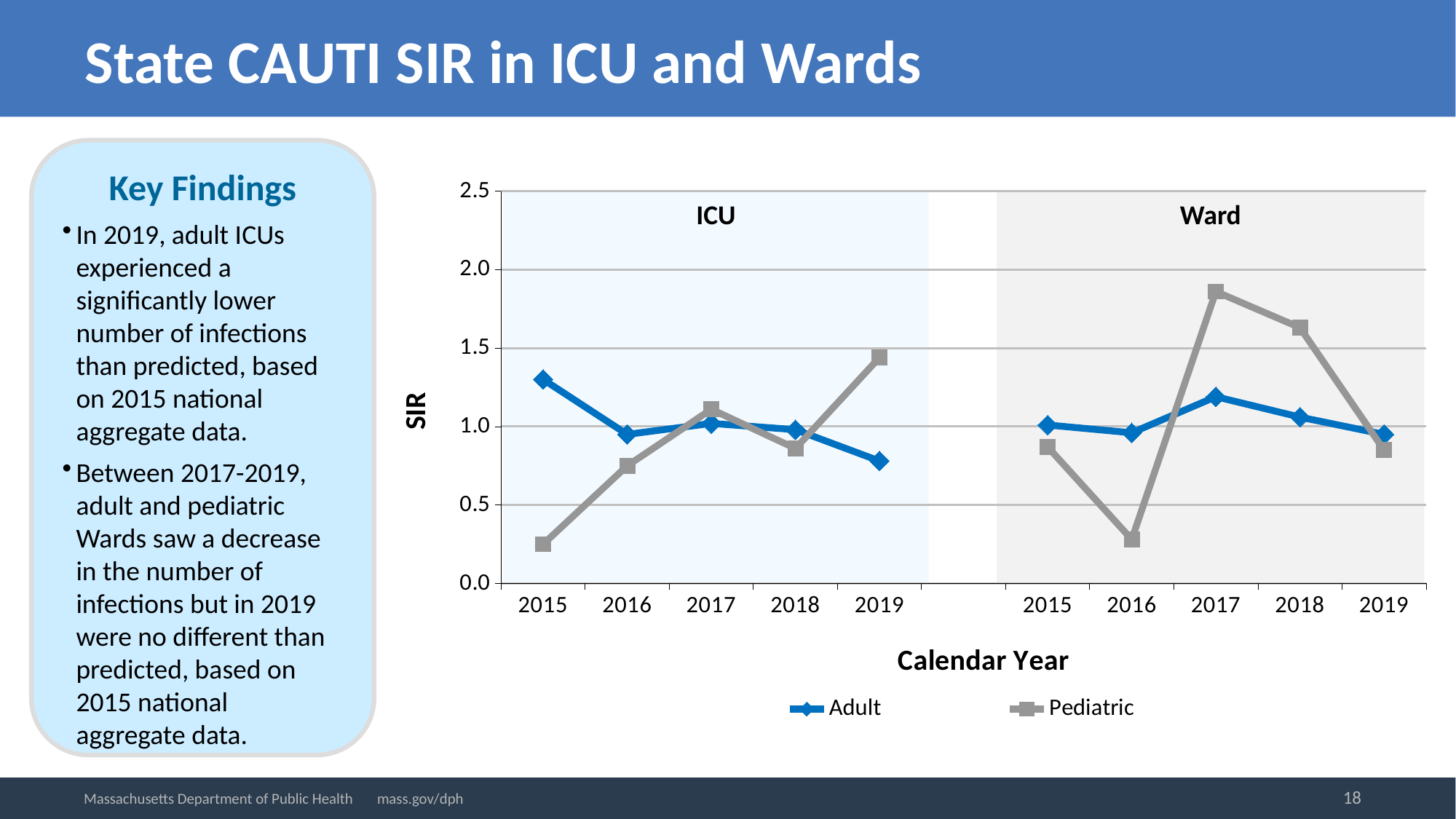
What is the label on the vertical axis of the chart? SIR In the Ward panel, is the Pediatric SIR for 2017 greater or less than 1.5? greater In the ICU panel, which year has the highest Adult SIR? 2015 How many calendar years are plotted in the ICU panel of the chart? 5 In the ICU panel for 2019, which series has the higher SIR, Adult or Pediatric? Pediatric In the Ward panel, which year has the highest Pediatric SIR? 2017 In the ICU panel, is the Adult SIR for 2015 greater or less than 1.0? greater In the ICU panel, is the Pediatric SIR for 2015 greater or less than 0.5? less How many series does the chart legend list? 2 In the Ward panel, which year has the lowest Pediatric SIR? 2016 What are the two series named in the chart legend? Adult and Pediatric What kind of chart is shown on the slide? line chart